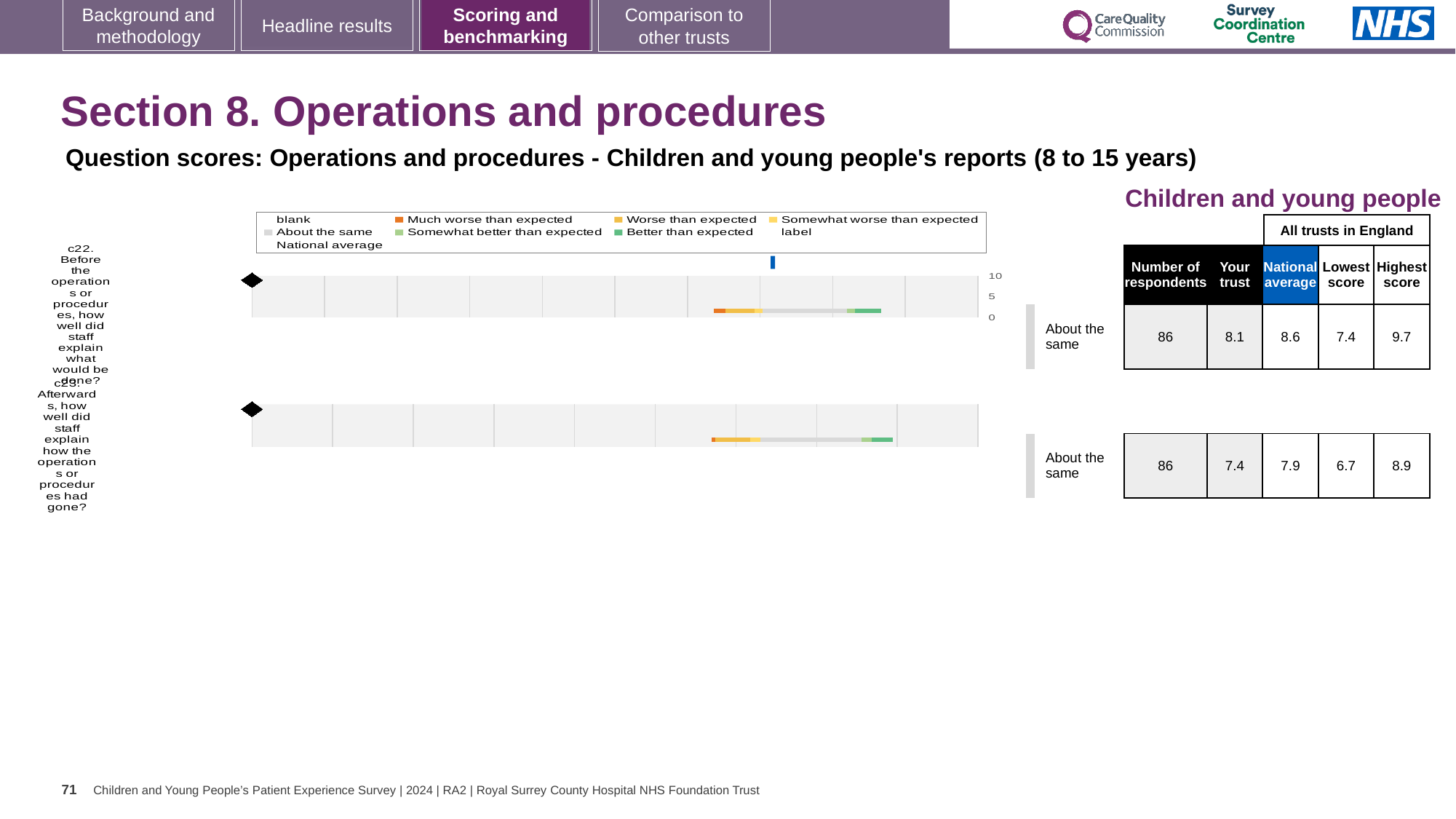
How many respondents are shown for question c22? 86 Which question has the higher 'Your trust' score, c22 or c23? c22 For question c22, which is larger: the 'Your trust' score or the national average? National average How many entries does the chart legend list? 9 For question c23, what is the difference between the national average (7.9) and the 'Your trust' score (7.4)? 0.5 For question c22, what is the national average score shown? 8.6 What colour does the legend use for 'Much worse than expected'? orange How many questions (c22 and c23) are plotted as bars on the slide? 2 For question c22 (Before the operations or procedures, how well did staff explain what would be done?), what is the 'Your trust' score shown? 8.1 For question c23, what is the highest score among all trusts in England? 8.9 What kind of chart is used to show the question scores on this slide? bar chart For question c23 (Afterwards, how well did staff explain how the operations or procedures had gone?), what is the 'Your trust' score shown? 7.4